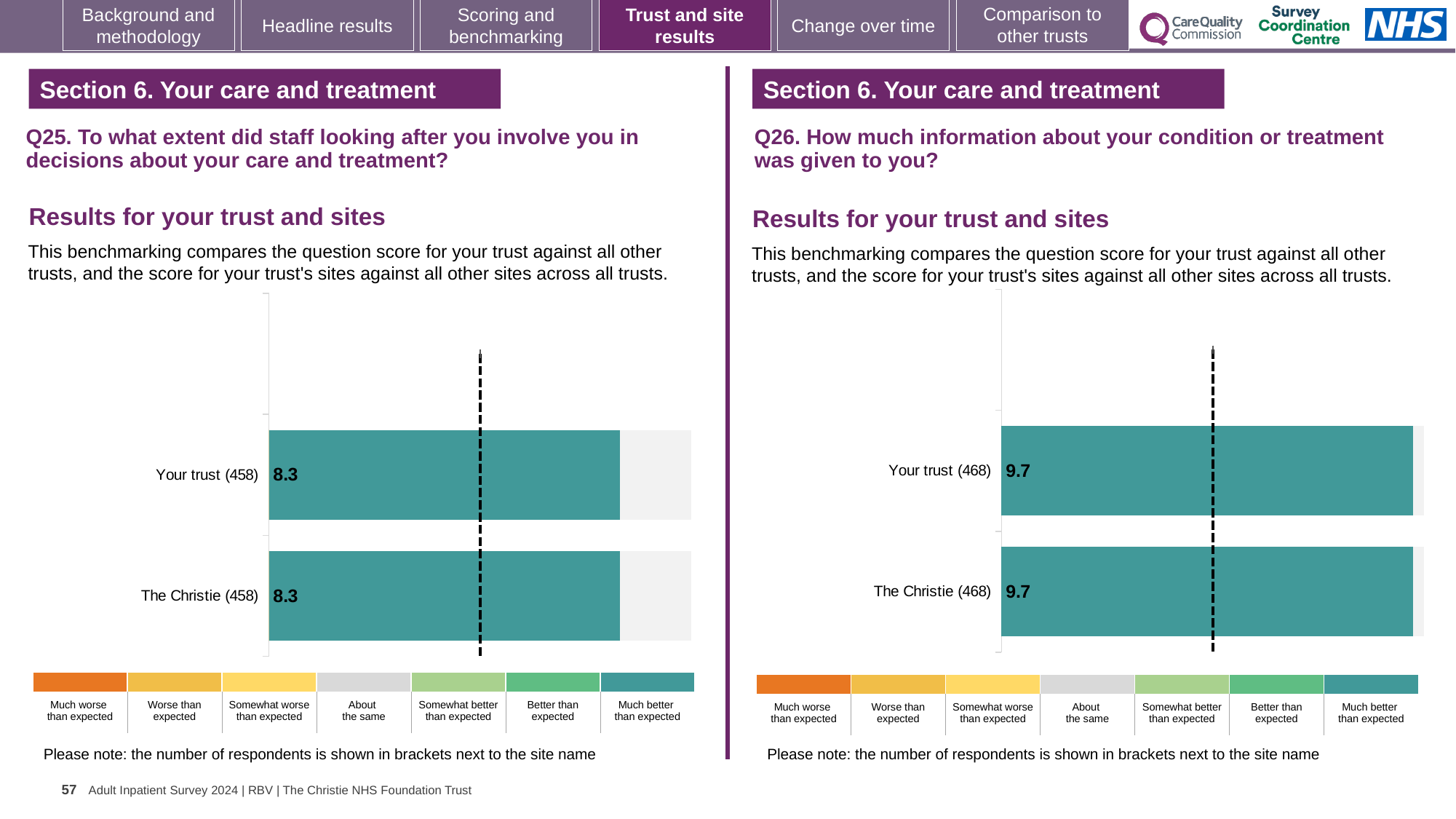
On the Q26 chart (right), what is the difference between the score for Your trust and the score for The Christie? 0 On the Q25 chart (left), what is the score for Your trust? 8.3 On the Q26 chart (right), what is the score for The Christie? 9.7 How many bars are plotted on the Q25 chart (left)? 2 On the Q25 chart (left), what is the difference between the score for Your trust and the score for The Christie? 0 What kind of chart is the Q25 chart (left)? Bar chart On the Q26 chart (right), what is the score for Your trust? 9.7 How many bars are plotted on the Q26 chart (right)? 2 On the Q25 chart (left), what is the score for The Christie? 8.3 Is the score for Your trust on the Q26 chart (right) larger or smaller than the score for Your trust on the Q25 chart (left)? Larger On the Q26 chart (right), how many respondents are shown in brackets next to The Christie? 468 On the Q25 chart (left), how many respondents are shown in brackets next to Your trust? 458